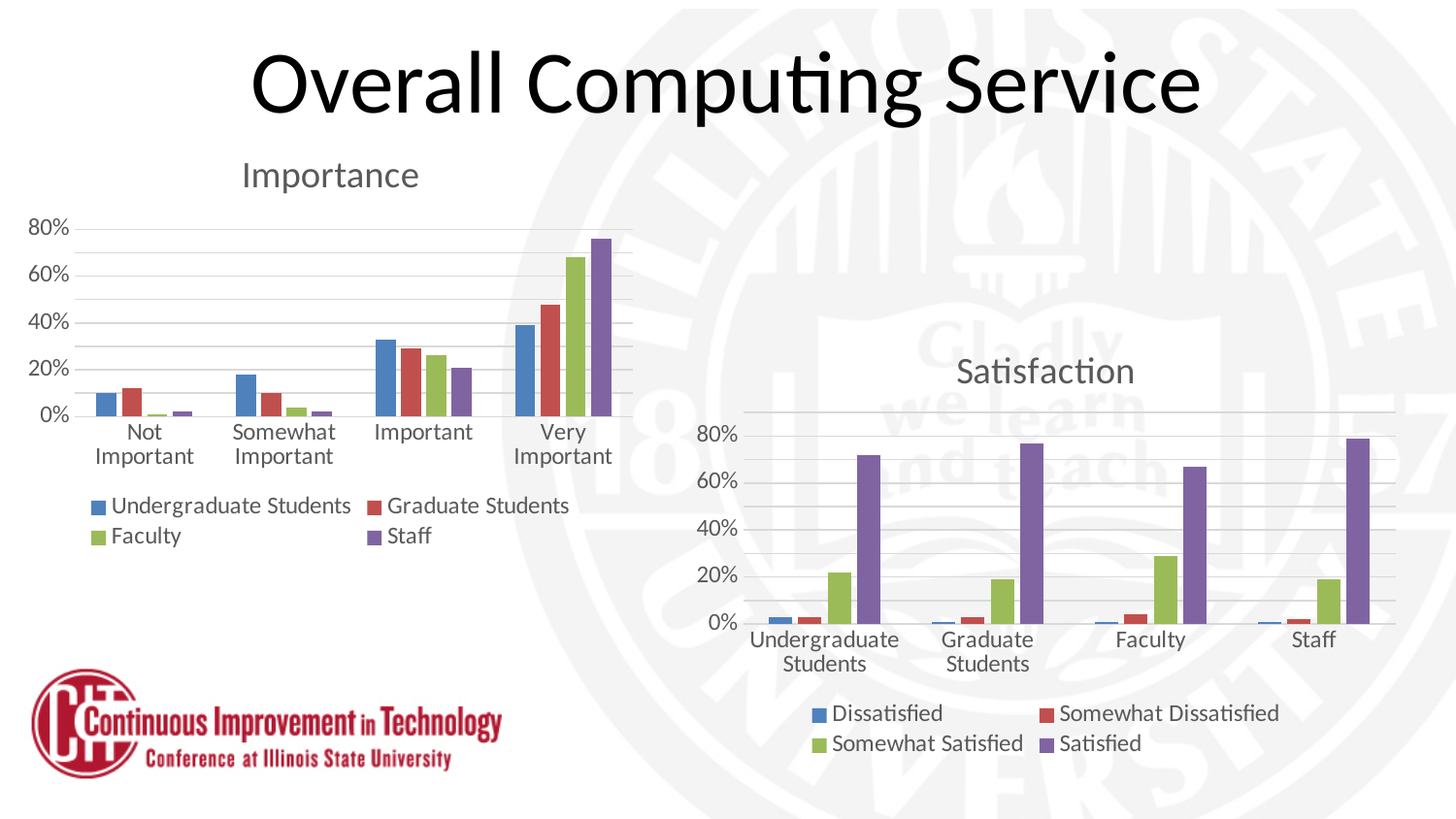
In the Importance chart, is the Staff value for Very Important greater or less than 60%? greater In the Importance chart, how many categories are shown on the x axis? 4 In the Satisfaction chart, for Undergraduate Students, which is larger: Satisfied or Somewhat Satisfied? Satisfied In the Importance chart, which group has the lowest bar for Very Important? Undergraduate Students In the Importance chart, do the Staff values rise or fall from Not Important to Very Important? rise In the Satisfaction chart, how many series does the legend list? 4 In the Importance chart, which group has the tallest bar for Very Important? Staff In the Satisfaction chart, is the Faculty value for Somewhat Satisfied greater or less than 20%? greater In the Importance chart, is the Faculty value for Not Important greater or less than 20%? less In the Importance chart, how many series does the legend list? 4 In the Satisfaction chart, which group has the lowest Satisfied bar? Faculty What kind of chart is the Importance chart? bar chart